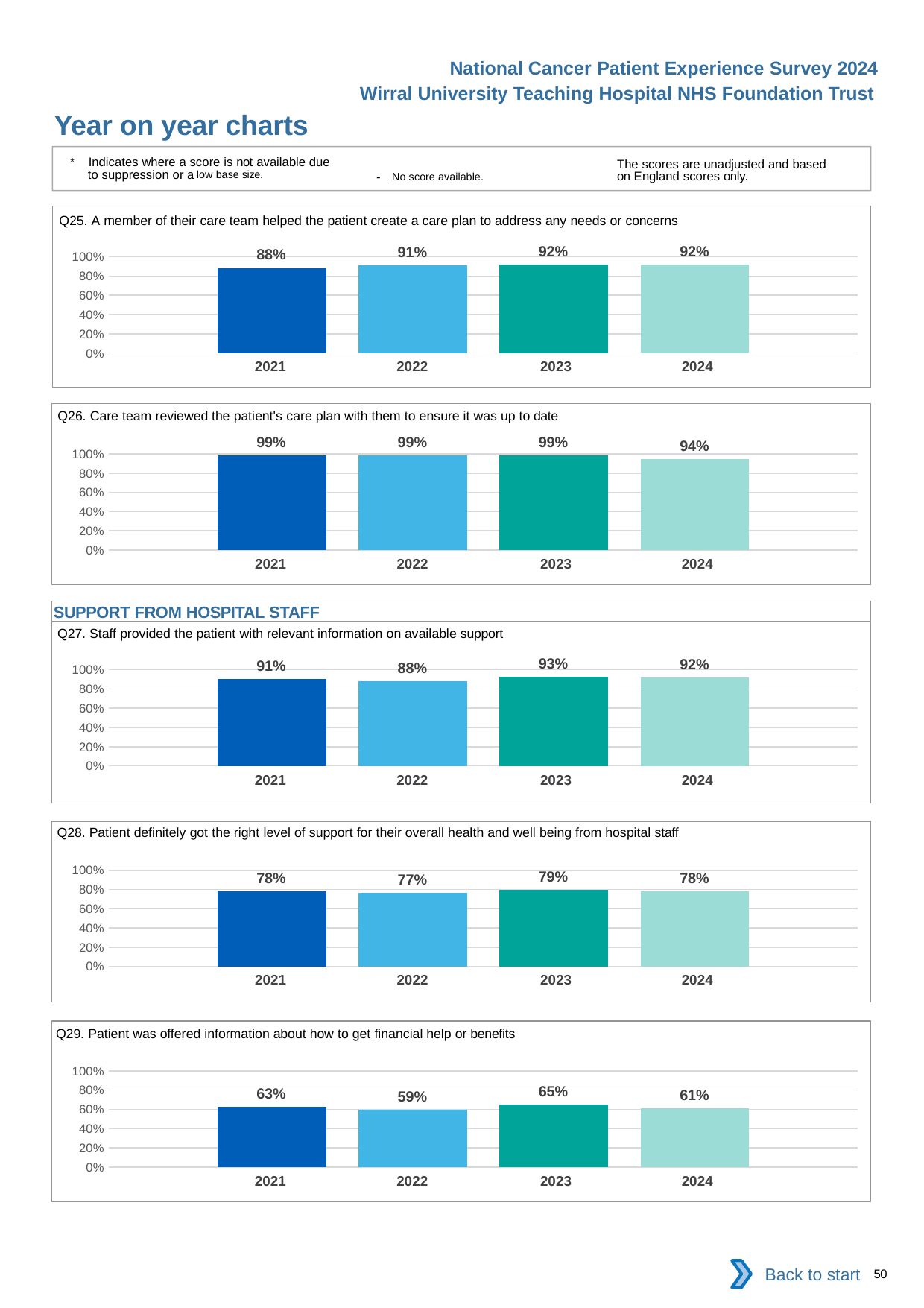
What is the section heading shown above the Q27 chart? SUPPORT FROM HOSPITAL STAFF In the Q26 chart, what is the value for 2024? 94% In the Q26 chart, does the value rise or fall from 2023 to 2024? fall In the Q29 chart, what is the difference between the 2023 value and the 2022 value? 6% How many years are shown in the Q28 chart? 4 In the Q29 chart, is the value for 2022 greater or less than 80%? less In the Q27 chart, which year has the highest value? 2023 In the Q28 chart, which is larger, the value for 2023 or the value for 2022? 2023 In the Q25 chart, what is the value for 2021? 88% What kind of chart is the Q25 chart? bar chart In the Q27 chart, which year has the lowest value? 2022 In the Q29 chart, which year has the highest value? 2023